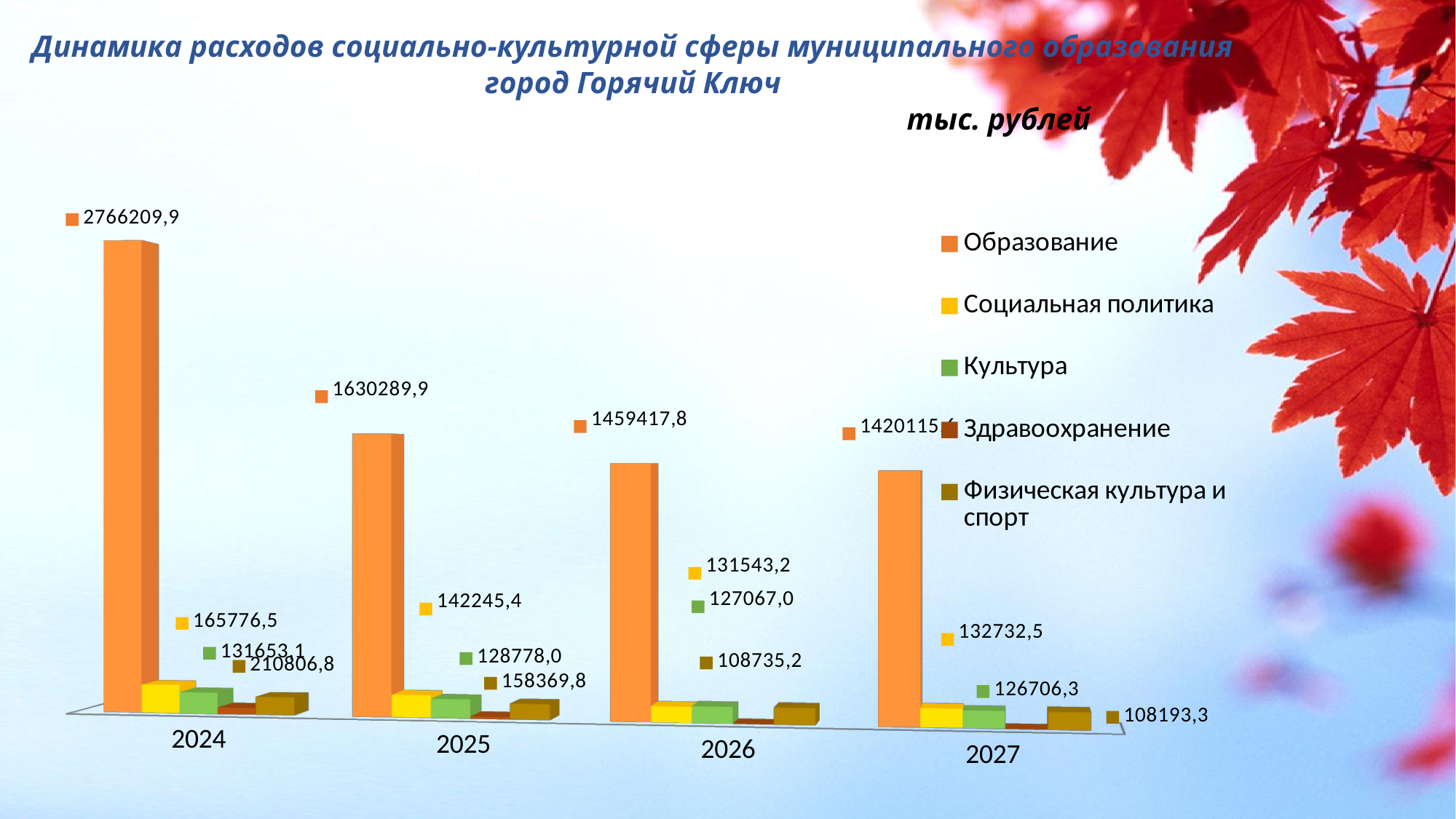
What is the difference between the Образование values for 2024 and 2025? 1135920,0 Do the values for Образование rise or fall from 2024 to 2027? fall How many years are shown on the x axis? 4 What kind of chart is shown on the slide? bar chart What is the value for Образование in 2024? 2766209,9 How many series does the legend list? 5 In which year is the value for Образование highest? 2024 What is the value for Культура in 2026? 127067,0 What is the value for Физическая культура и спорт in 2027? 108193,3 What is the value for Социальная политика in 2025? 142245,4